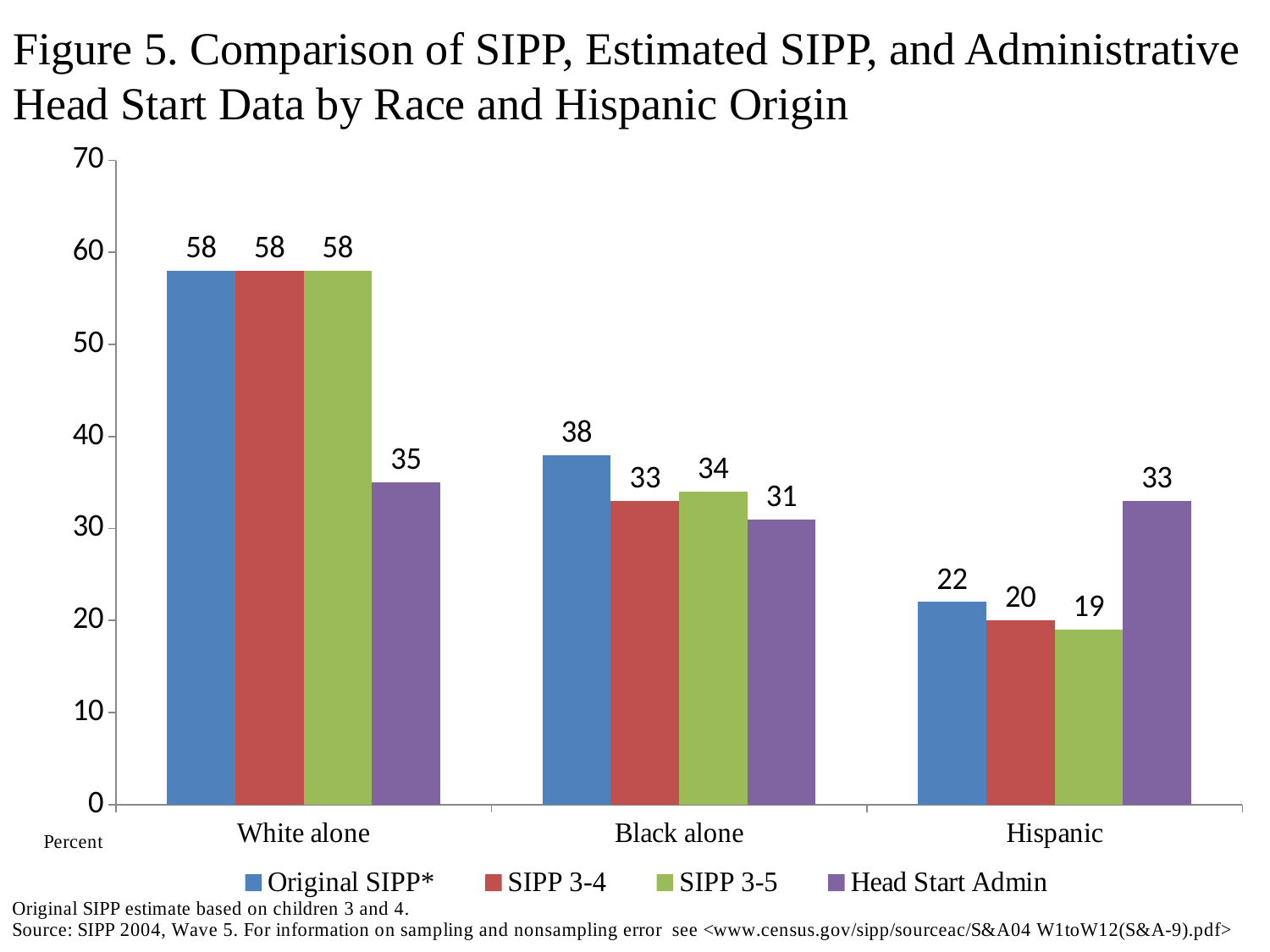
Which category has the highest Head Start Admin value? White alone What kind of chart is shown on the slide? bar chart What is the difference between the Original SIPP* value and the Head Start Admin value for White alone? 23 Which category has the lowest SIPP 3-4 value? Hispanic How many categories are shown on the x axis? 3 What unit is shown on the y axis label? Percent What is the SIPP 3-5 value for White alone? 58 How many series does the legend list? 4 Which is larger for Hispanic: the SIPP 3-5 value or the Head Start Admin value? Head Start Admin What is the Original SIPP* value for Black alone? 38 Is the SIPP 3-4 value for Black alone greater or less than 30? greater What is the Head Start Admin value for Hispanic? 33